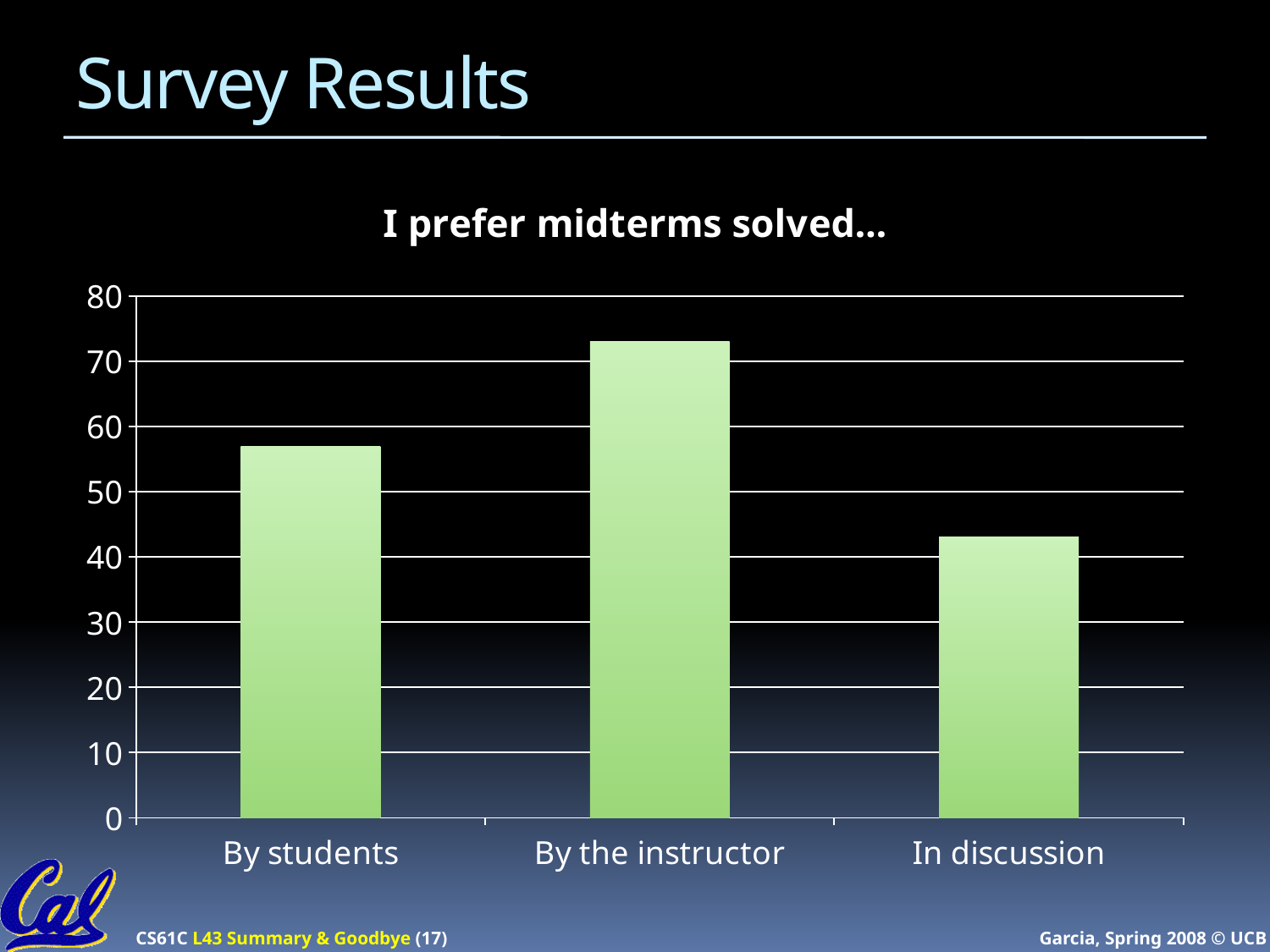
How many categories are shown on the x axis of the chart? 3 Is the value for In discussion greater or less than 50? less What kind of chart is shown on the slide? bar chart Which is larger, the value for By the instructor or the value for By students? By the instructor Which category has the lowest bar? In discussion Is the value for In discussion greater or less than 40? greater What is the maximum value shown on the y axis of the chart? 80 Is the value for By students greater or less than 50? greater What is the title of the chart? I prefer midterms solved... Which is larger, the value for By students or the value for In discussion? By students Which category has the highest bar? By the instructor